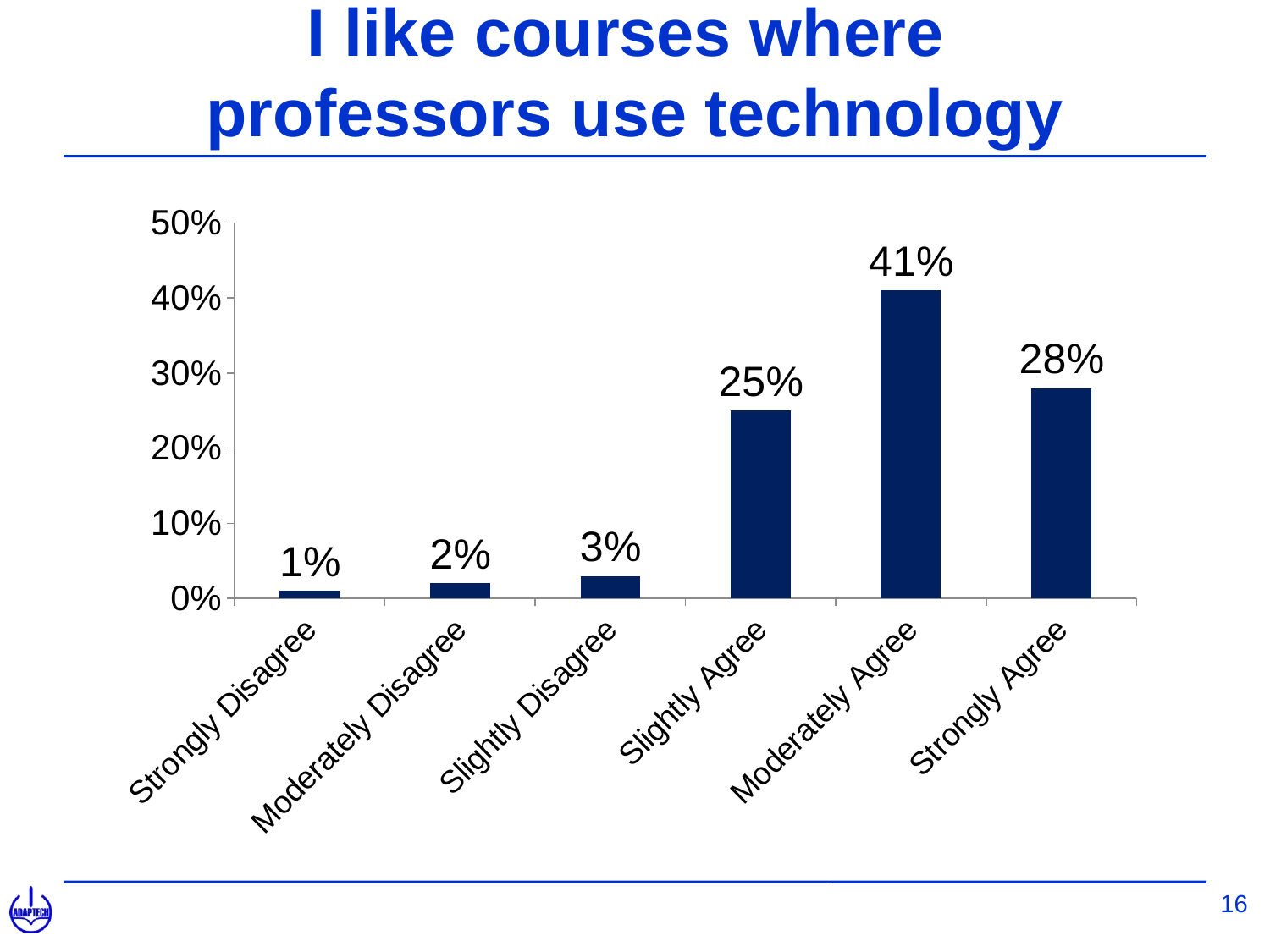
How many response categories are shown on the x axis? 6 Which response category has the lowest value? Strongly Disagree What percentage of respondents chose Moderately Agree? 41% What kind of chart is shown on the slide? Bar chart What is the title of the slide? I like courses where professors use technology Is the value for Moderately Agree greater or less than 40%? greater What is the difference between Moderately Agree and Strongly Agree? 13% What is the value for Strongly Disagree? 1% What is the value for Strongly Agree? 28% What is the value for Slightly Agree? 25% Which response category has the highest value? Moderately Agree Which is larger, Slightly Agree or Strongly Agree? Strongly Agree